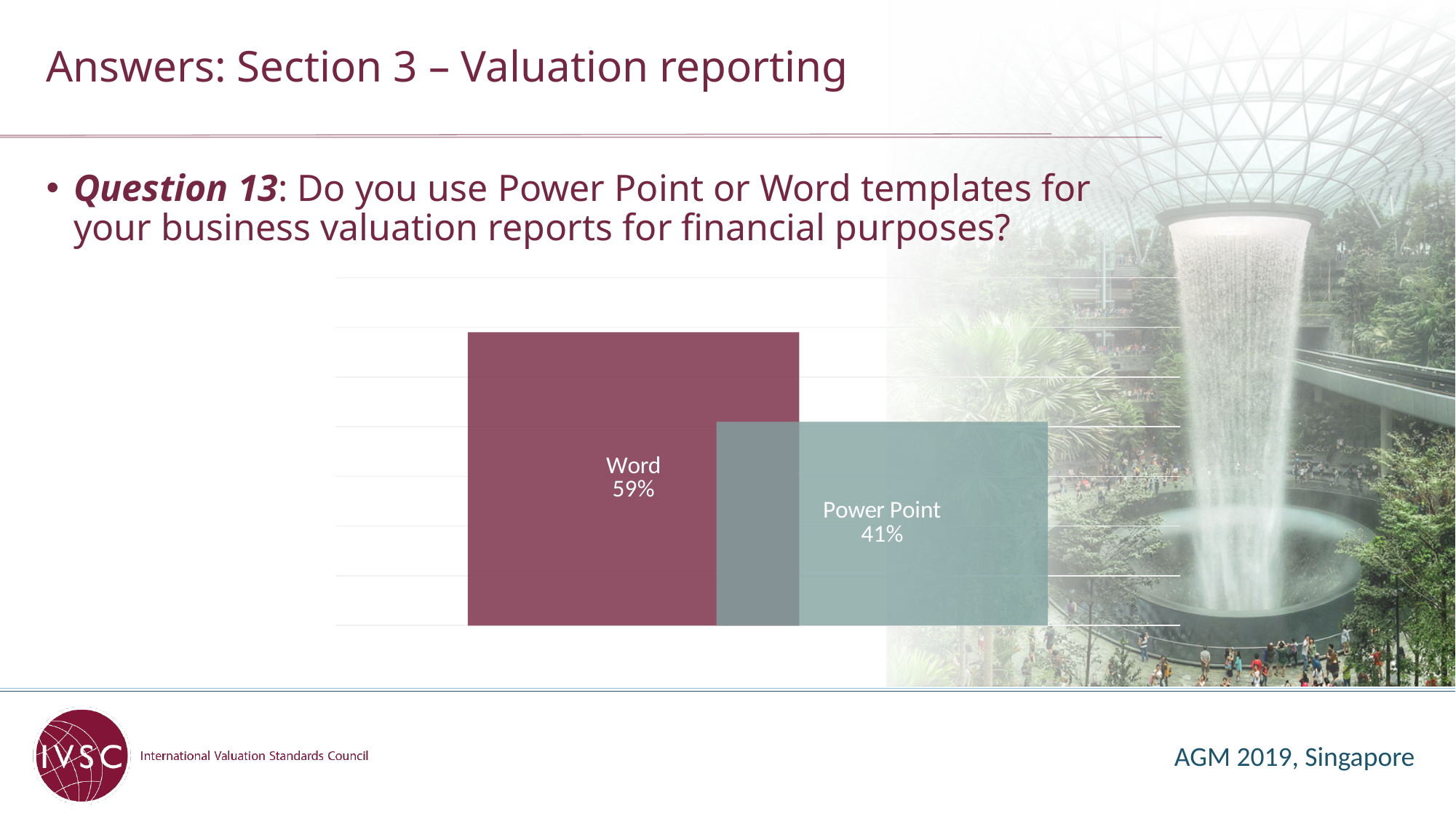
What kind of chart is shown on the slide? bar chart What is the difference in percentage points between the Word and Power Point shares? 18 What colour is the bar for Word? dark red What percentage of respondents use Power Point templates for their business valuation reports? 41% What percentage of respondents use Word templates for their business valuation reports? 59% Which survey question does the chart answer? Question 13 Which option has the higher share of respondents, Word or Power Point? Word Which option has the lower share of respondents? Power Point What is the total of the Word and Power Point percentages shown in the chart? 100% Is the value for Power Point larger or smaller than the value for Word? smaller How many categories are shown in the chart? 2